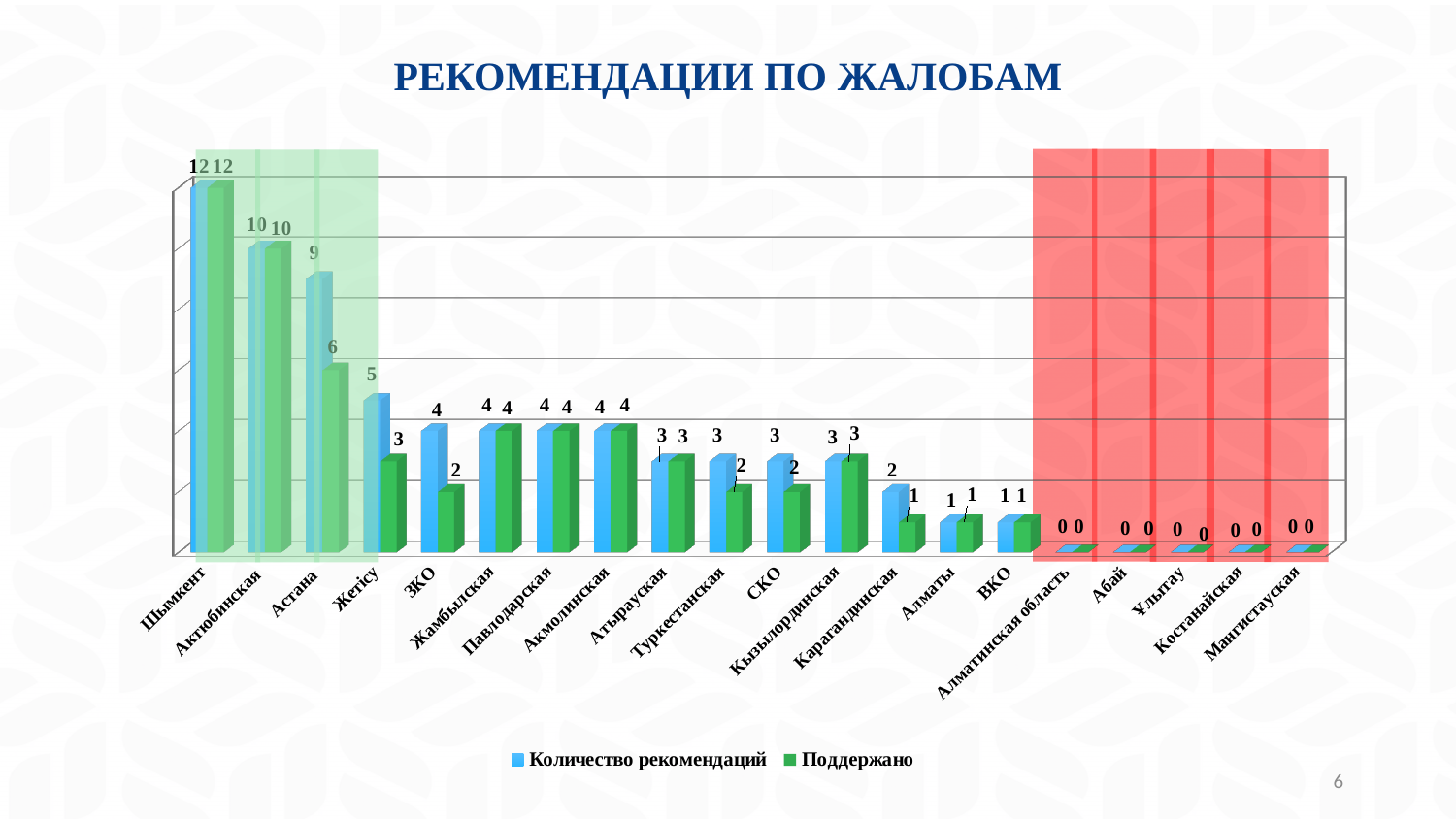
What is the value of Поддержано for ЗКО? 2 Which category has the highest value of Количество рекомендаций? Шымкент What is the difference between Количество рекомендаций for Шымкент and for Актюбинская? 2 What is the value of Количество рекомендаций for Астана? 9 How many series does the legend list? 2 Which is larger: Поддержано for Жамбылская or Поддержано for Туркестанская? Жамбылская Do the values of Количество рекомендаций rise or fall from left to right along the x axis? fall What kind of chart is shown on the slide? bar chart How many categories are shown on the x axis? 20 What is the difference between Количество рекомендаций and Поддержано for Астана? 3 What is the value of Поддержано for Жетісу? 3 What is the title of the chart? РЕКОМЕНДАЦИИ ПО ЖАЛОБАМ